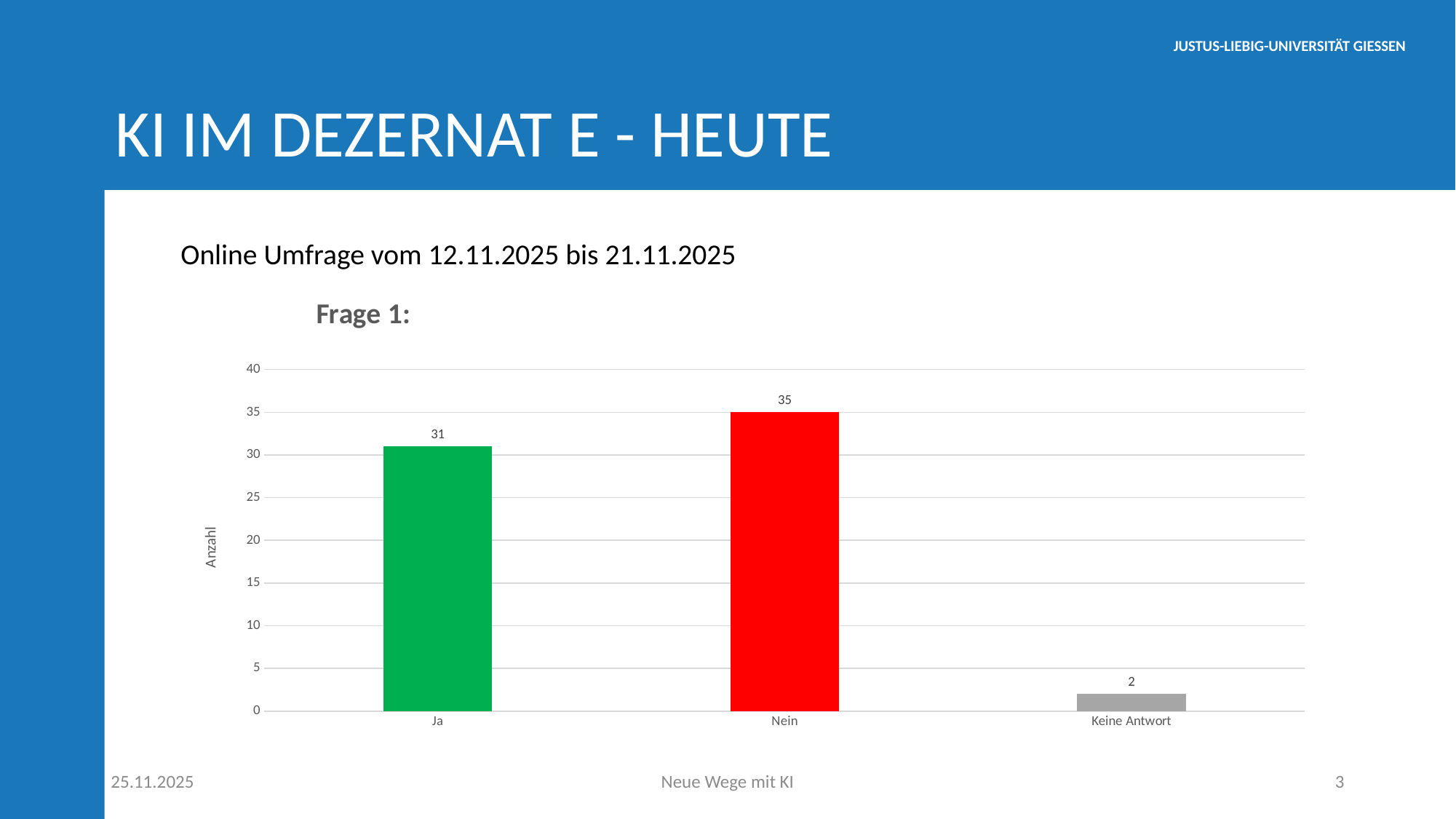
What is the title of the chart? Frage 1: What is the label of the y axis? Anzahl What kind of chart is shown on the slide? bar chart Which is larger, the value for Ja or the value for Nein? Nein How many categories are shown on the x axis? 3 What is the value for Ja? 31 Which category has the lowest value? Keine Antwort What is the difference between the values for Nein and Ja? 4 What is the value for Nein? 35 What is the value for Keine Antwort? 2 Is the value for Ja greater or less than 30? greater Which category has the highest value? Nein